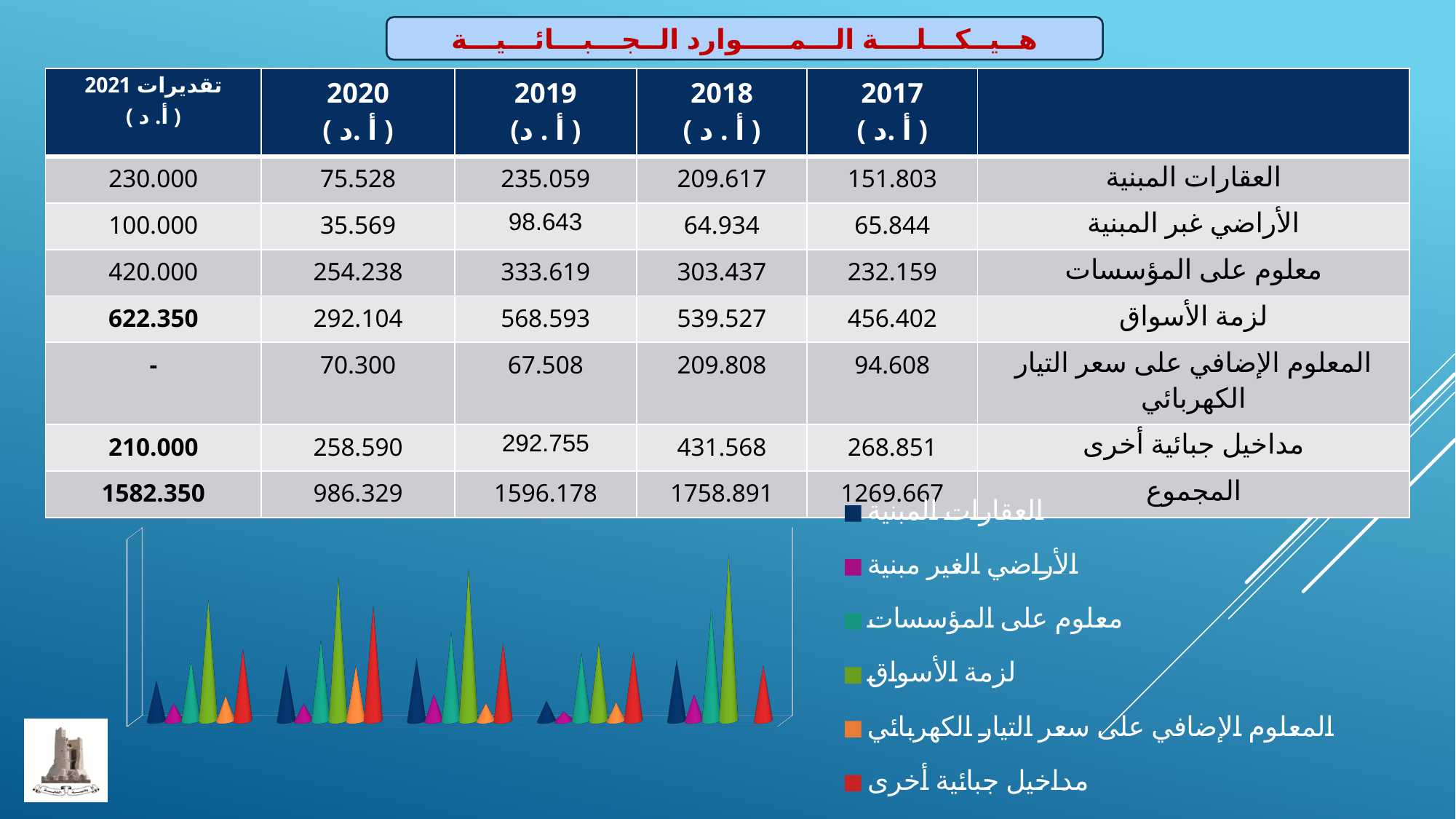
Which series is shown in green in the chart's legend? لزمة الأسواق How many clusters of bars are plotted in the chart? 5 How many series does the chart's legend list? 6 In the leftmost cluster of the chart, which is taller: the bar for العقارات المبنية or the bar for معلوم على المؤسسات? معلوم على المؤسسات In the rightmost cluster of the chart, which is taller: the bar for لزمة الأسواق or the bar for مداخيل جبائية أخرى? لزمة الأسواق What kind of chart is shown at the bottom of the slide? bar chart Which series has the tallest bar in every cluster of the chart? لزمة الأسواق Which series is shown in red in the chart's legend? مداخيل جبائية أخرى